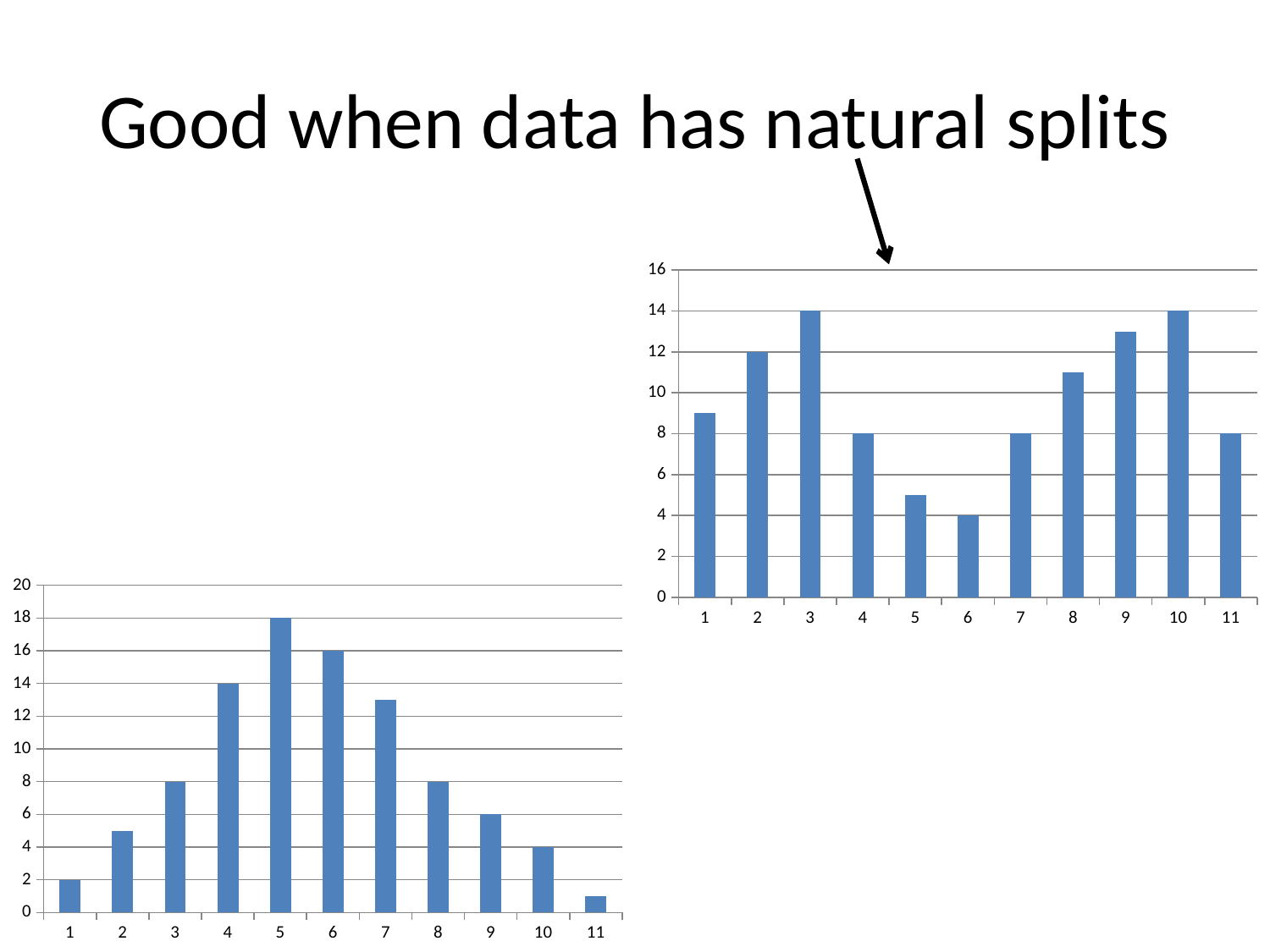
In the top-right chart, is the value for category 9 greater or less than 12? greater In the top-right chart, which is larger, the value for category 2 or the value for category 4? category 2 In the top-right chart, what is the value for category 6? 4 In the bottom-left chart, what is the value for category 4? 14 How many categories are shown on the x axis of the bottom-left chart? 11 In the top-right chart, what is the value for category 3? 14 In the bottom-left chart, which category has the highest value? 5 In the bottom-left chart, is the value for category 7 greater or less than 12? greater In the bottom-left chart, what is the value for category 5? 18 In the bottom-left chart, what is the difference between the values for category 5 and category 6? 2 In the bottom-left chart, which category has the lowest value? 11 What kind of chart is the chart at the bottom left of the slide? bar chart